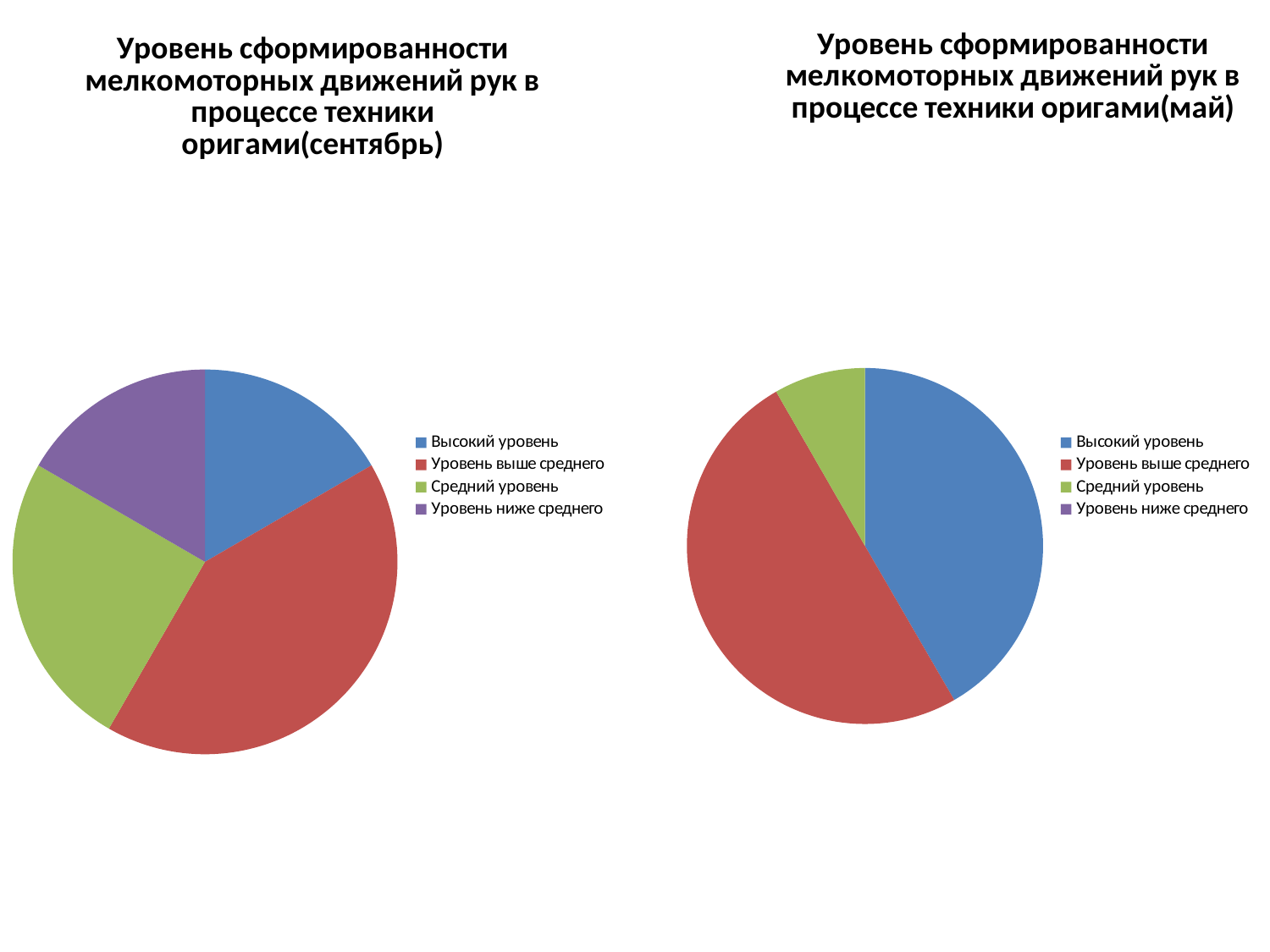
In the right chart (май), which category has the largest slice? Уровень выше среднего In the right chart (май), which visible slice is the smallest? Средний уровень How many categories does the legend of the left chart (сентябрь) list? 4 How many slices are visible in the right chart (май)? 3 What kind of chart is the right chart (май)? pie chart Is the Высокий уровень slice larger in the left chart (сентябрь) or in the right chart (май)? right chart (май) What colour represents Уровень ниже среднего in the legend of the left chart (сентябрь)? purple What kind of chart is the left chart (сентябрь)? pie chart How many categories does the legend of the right chart (май) list? 4 In the right chart (май), which slice is larger: Высокий уровень or Средний уровень? Высокий уровень In the left chart (сентябрь), which category has the largest slice? Уровень выше среднего In the left chart (сентябрь), which slice is larger: Средний уровень or Высокий уровень? Средний уровень